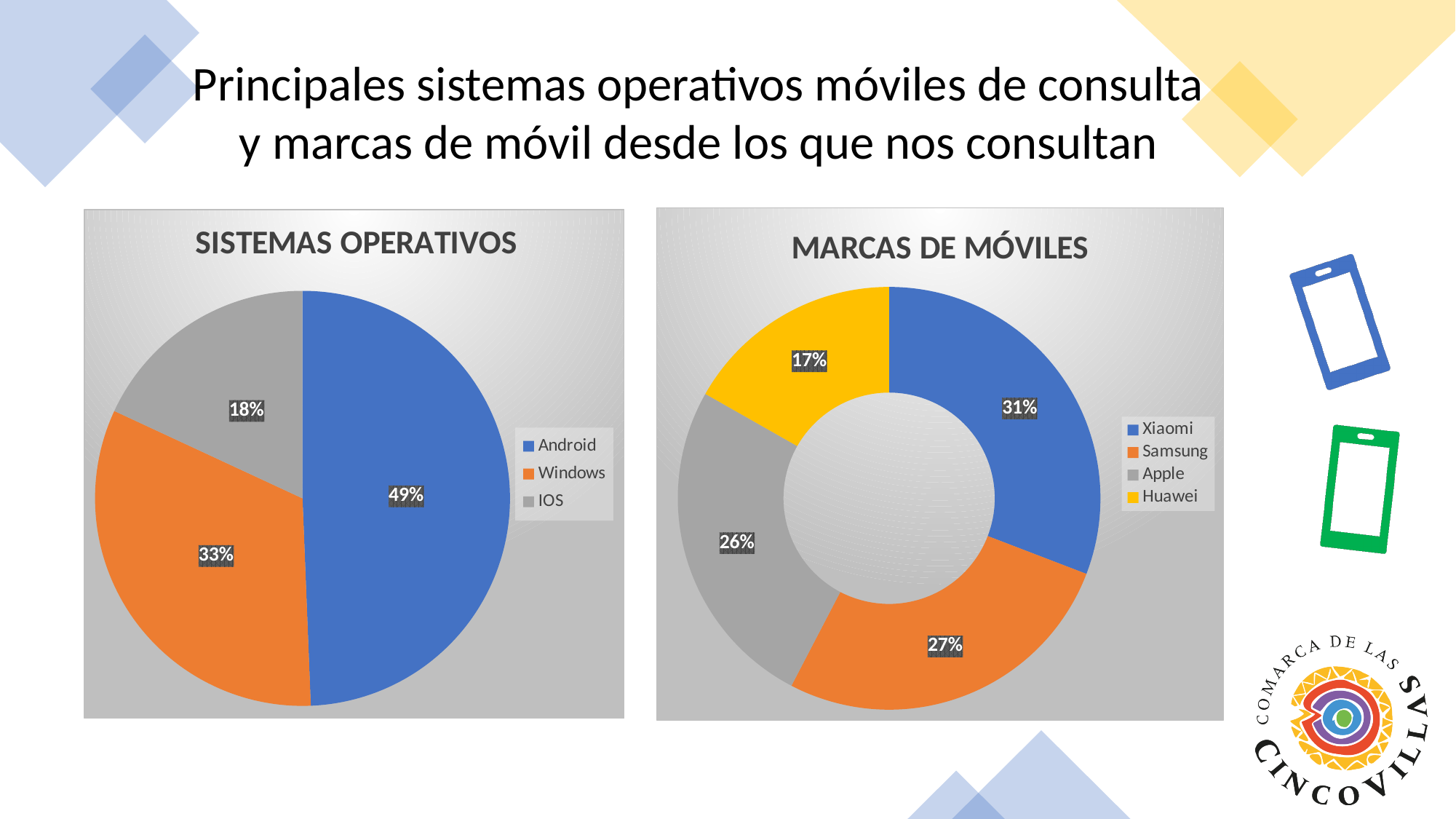
In the MARCAS DE MÓVILES chart, how many brands are shown? 4 In the SISTEMAS OPERATIVOS chart, what is the difference between the Android and Windows shares? 16% In the MARCAS DE MÓVILES chart, what share does Xiaomi have? 31% In the SISTEMAS OPERATIVOS chart, what share does Windows have? 33% In the MARCAS DE MÓVILES chart, what share does Huawei have? 17% In the SISTEMAS OPERATIVOS chart, what share does Android have? 49% In the MARCAS DE MÓVILES chart, what is the difference between the Samsung and Apple shares? 1% In the SISTEMAS OPERATIVOS chart, how many categories does the legend list? 3 In the MARCAS DE MÓVILES chart, which brand has the largest share? Xiaomi In the MARCAS DE MÓVILES chart, which colour represents Apple? Grey What kind of chart is the SISTEMAS OPERATIVOS chart? Pie chart In the SISTEMAS OPERATIVOS chart, which category has the smallest slice? IOS